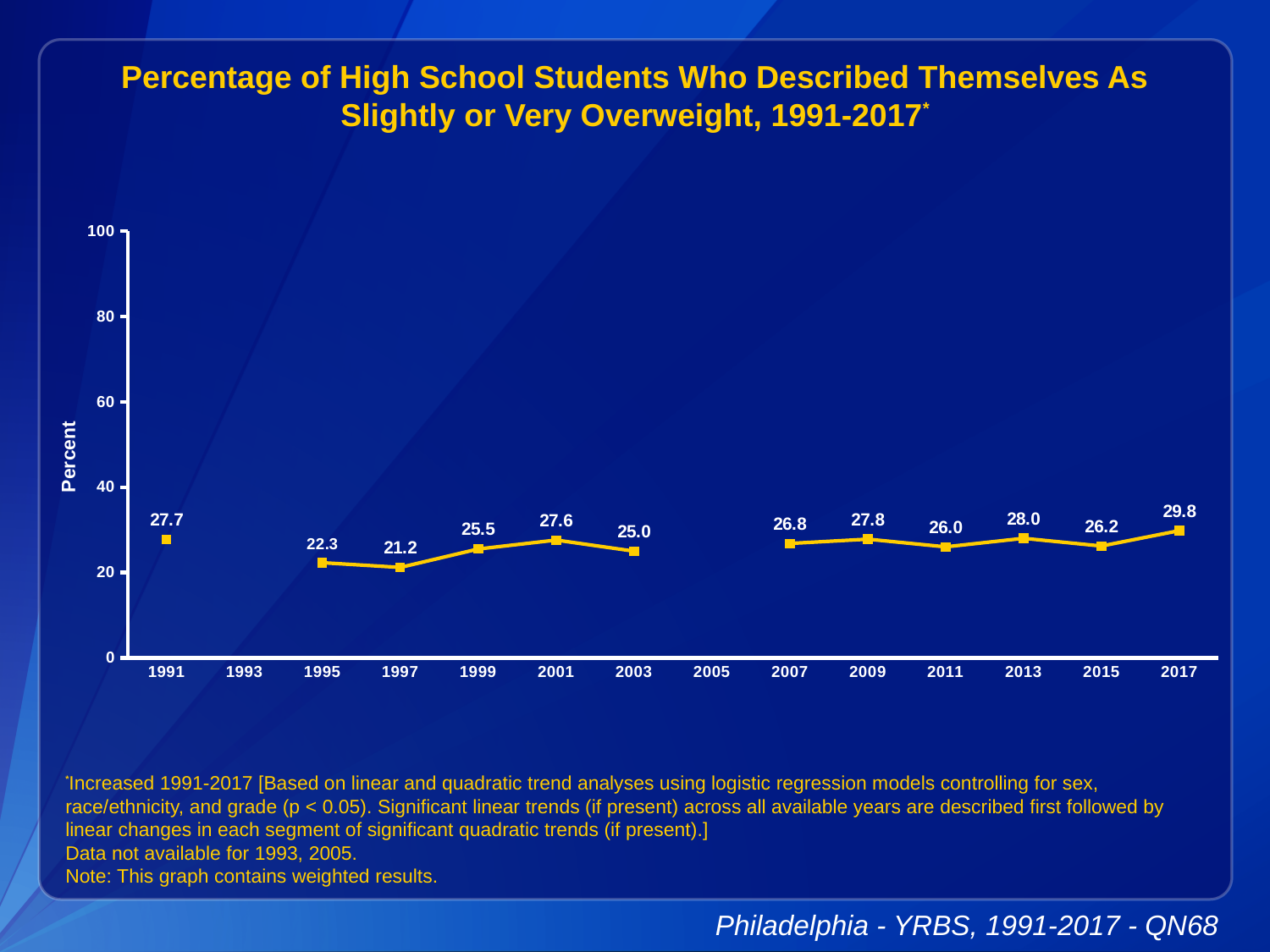
Is the value for 2009 greater or less than 40? less What kind of chart is shown on the slide? line chart What is the value plotted for 2017? 29.8 What is the difference between the values for 2013 and 2015? 1.8 What is the label on the y axis? Percent What percentage of high school students described themselves as slightly or very overweight in 1991? 27.7 Which year has the lowest plotted value? 1997 Which year has the highest plotted value? 2017 Which year has a larger value, 2001 or 2011? 2001 What is the difference between the values for 2017 and 1997? 8.6 What is the value plotted for 2003? 25.0 How many years have data points plotted on the chart? 12